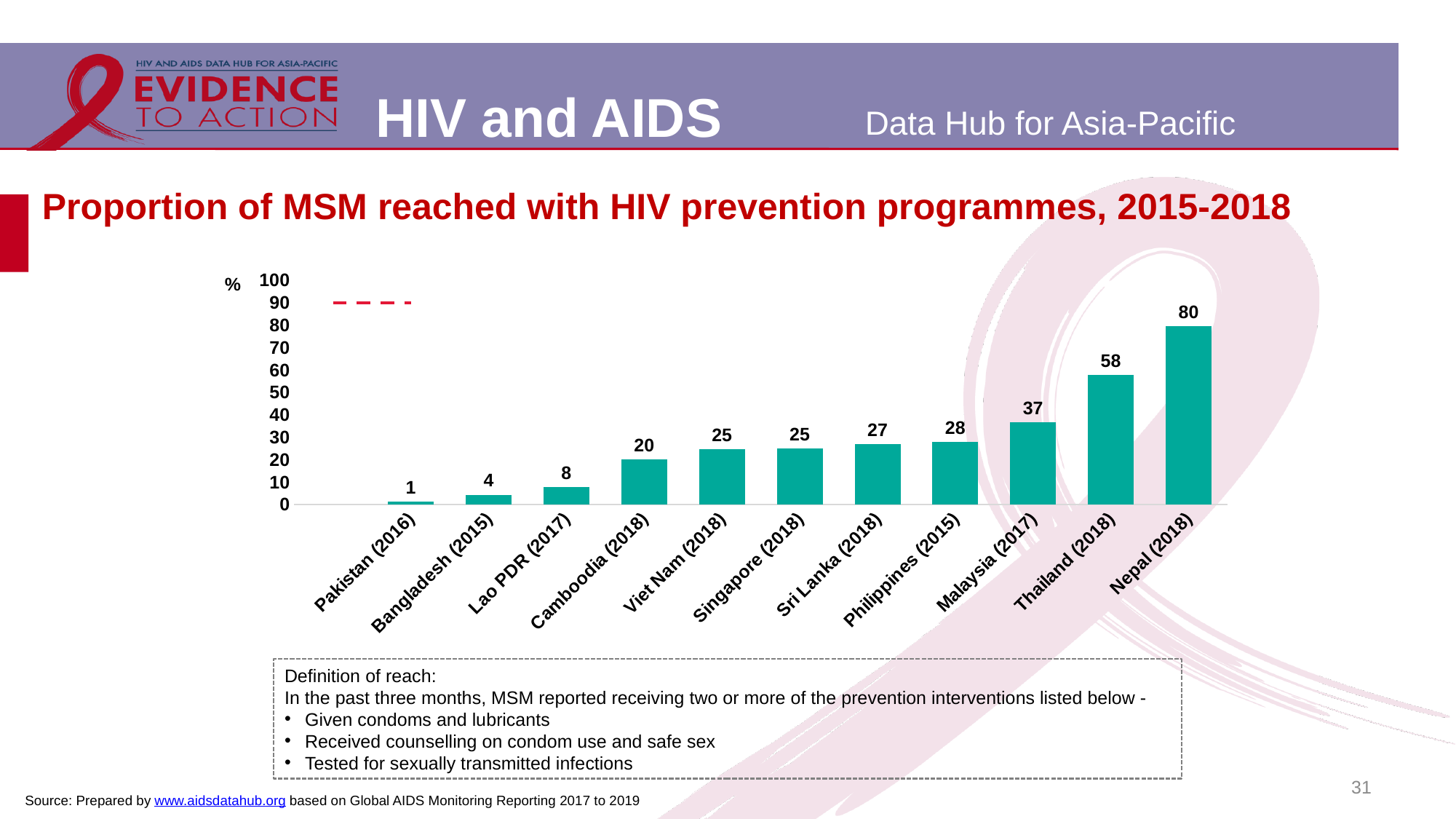
Which country has the lowest proportion of MSM reached? Pakistan (2016) What kind of chart is shown on the slide? bar chart What is the value for Cambodia (2018)? 20 Do the values rise or fall from left to right along the x axis? rise What is the value for Nepal (2018)? 80 What is the difference between the values for Nepal (2018) and Thailand (2018)? 22 Which is larger, the value for Sri Lanka (2018) or the value for Philippines (2015)? Philippines (2015) Which country has the highest proportion of MSM reached? Nepal (2018) What is the title of the chart? Proportion of MSM reached with HIV prevention programmes, 2015-2018 Is the value for Thailand (2018) greater or less than 50? greater What is the value for Malaysia (2017)? 37 How many countries are shown on the chart? 11